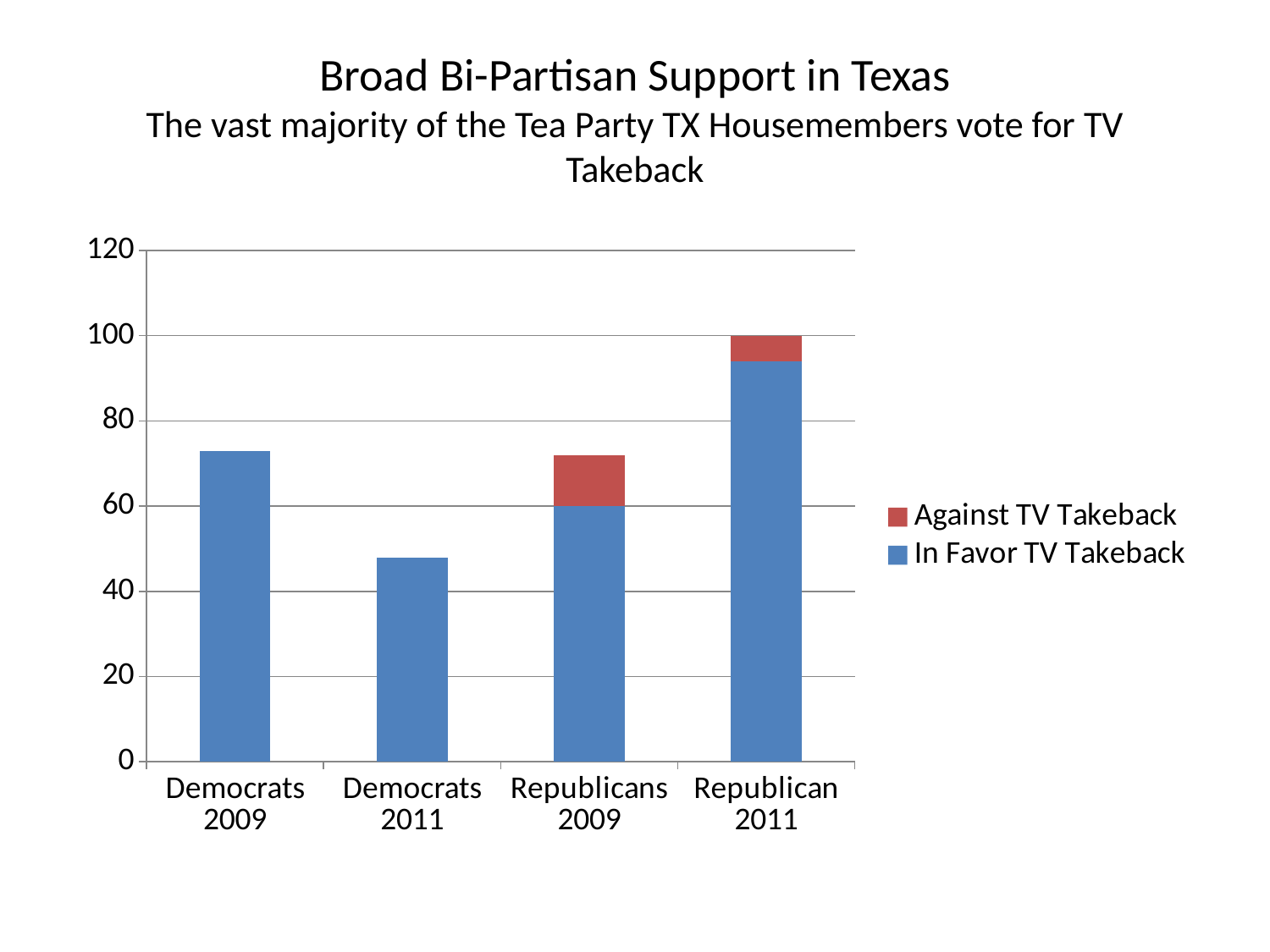
Which category has the tallest stacked bar? Republican 2011 What kind of chart is shown on the slide? bar chart Is the In Favor TV Takeback value for Democrats 2011 greater or less than 60? less Is the total stacked bar for Republicans 2009 greater or less than 80? less Which is larger, the In Favor TV Takeback value for Democrats 2009 or for Democrats 2011? Democrats 2009 What colour represents the Against TV Takeback series in the legend? red Which categories show an Against TV Takeback segment? Republicans 2009 and Republican 2011 Which category has the shortest bar? Democrats 2011 Is the In Favor TV Takeback value for Democrats 2009 greater or less than 60? greater How many series does the chart's legend list? 2 How many categories are shown on the x axis of the chart? 4